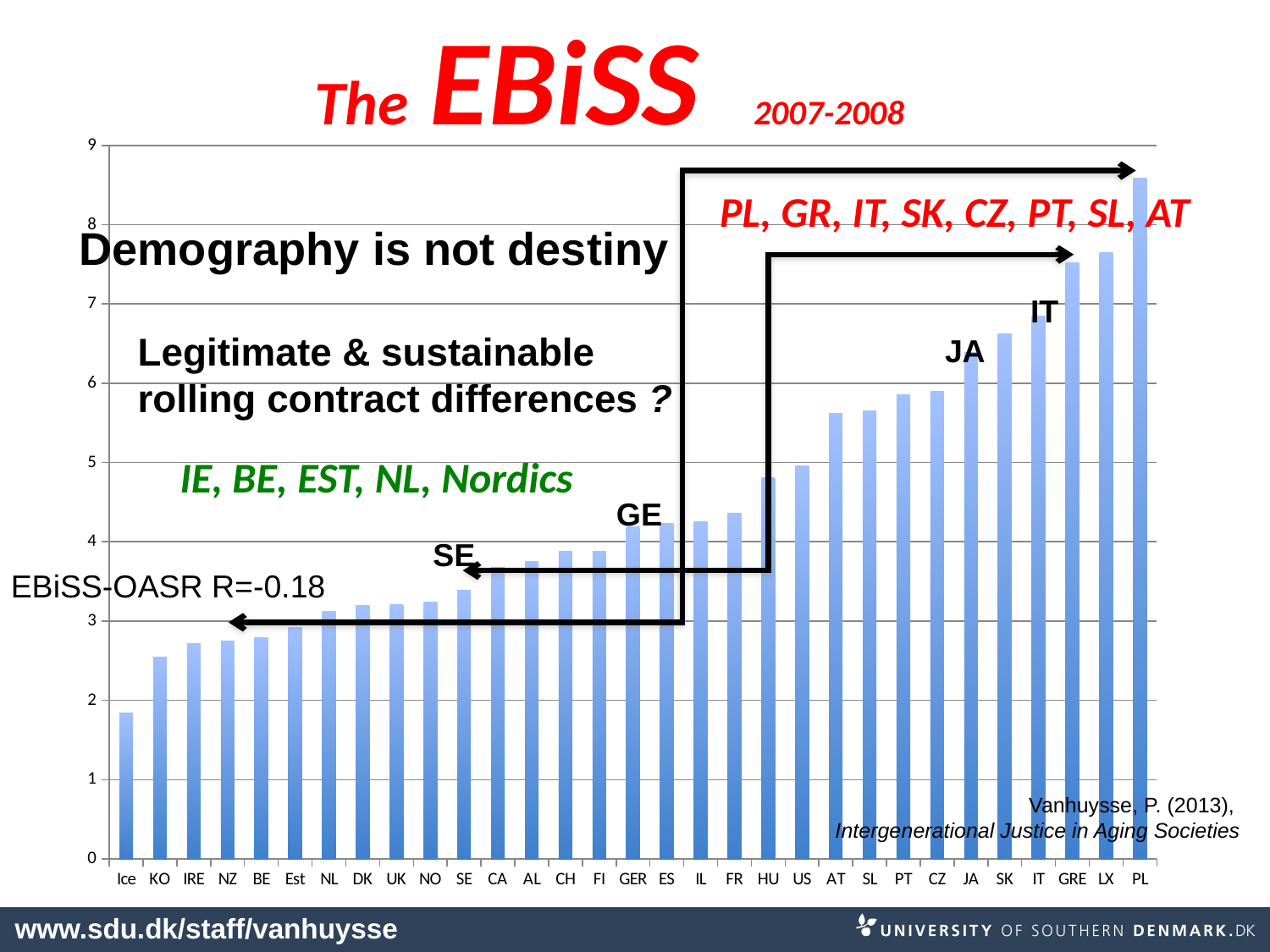
Which country has the lowest EBiSS value? Ice Is the value for HU greater or less than 5? less Is the value for Ice greater or less than 2? less How many countries are plotted along the x axis? 31 What kind of chart is shown on the slide? bar chart Is the value for IT greater or less than 7? less Which years does the chart title say the EBiSS data cover? 2007-2008 Which country has the highest EBiSS value? PL Which has the larger value, GER or HU? HU Do the bar values rise or fall from left to right along the x axis? rise